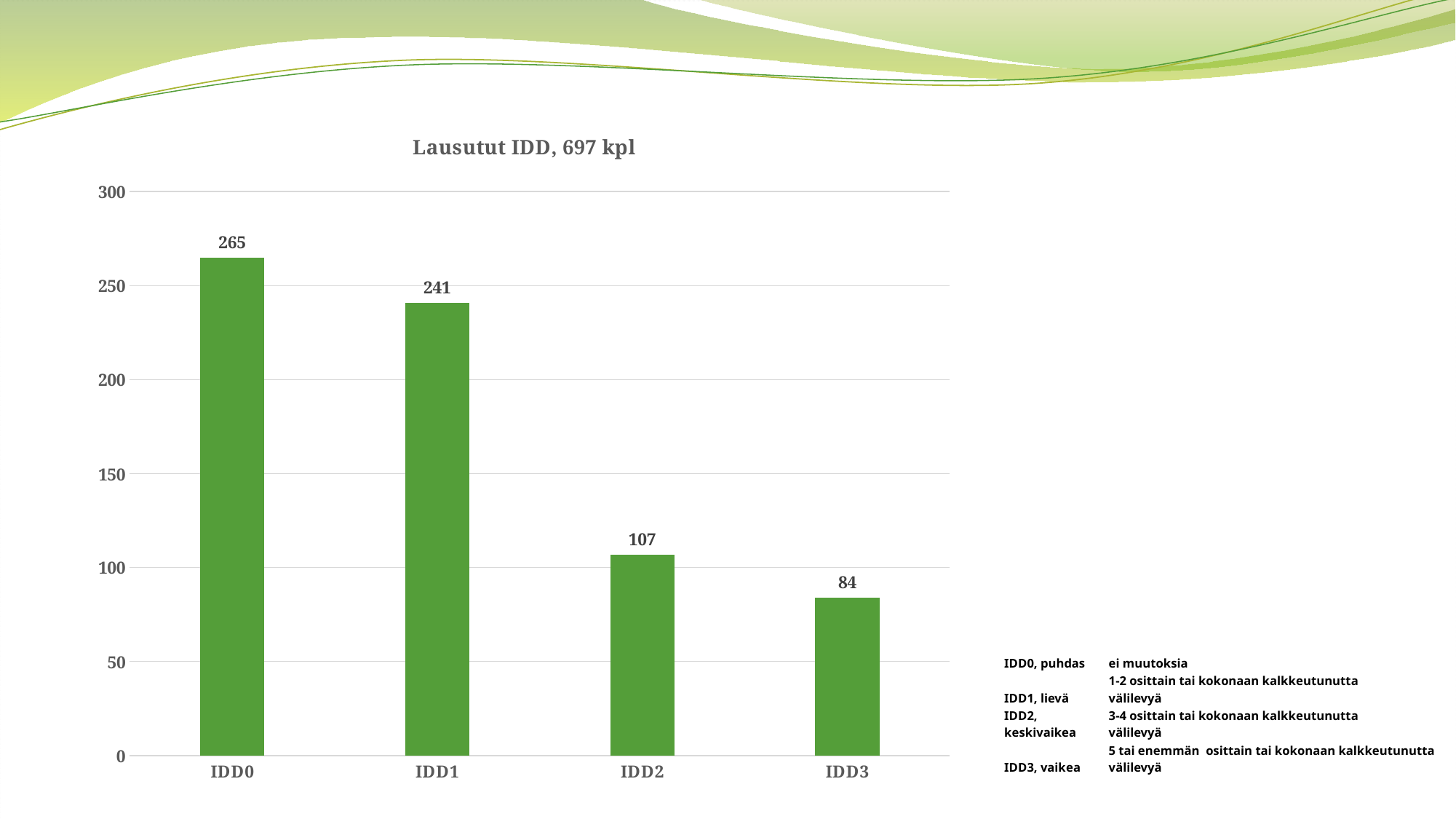
Which category has the lowest value? IDD3 What kind of chart is shown on the slide? bar chart What is the value for IDD3? 84 What is the difference between the values for IDD2 and IDD3? 23 Which category has the highest value? IDD0 How many categories are shown on the x axis? 4 What is the value for IDD0? 265 What is the value for IDD1? 241 What is the value for IDD2? 107 What is the title of the chart? Lausutut IDD, 697 kpl What is the difference between the values for IDD0 and IDD1? 24 Which is larger, the value for IDD1 or the value for IDD2? IDD1